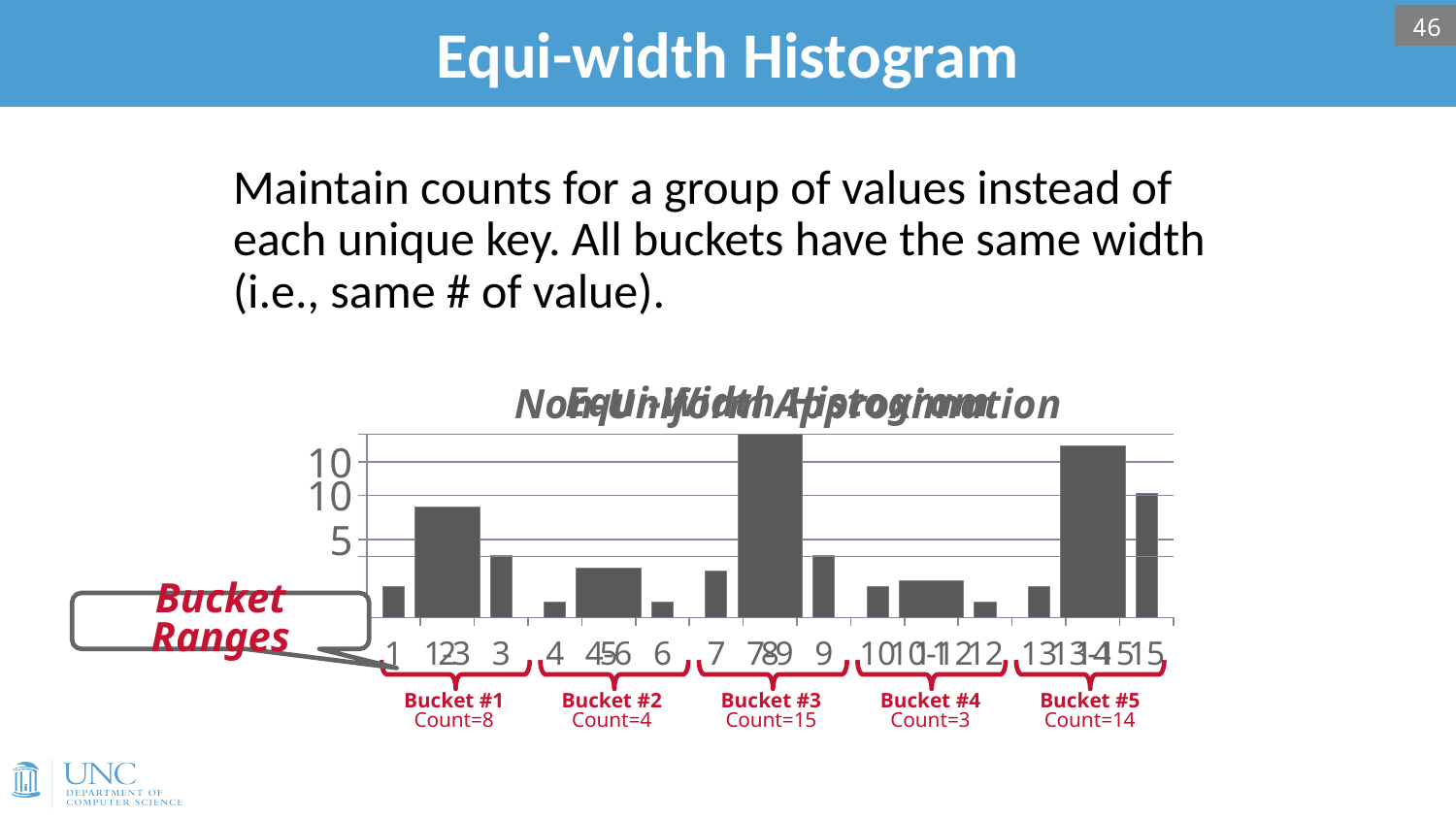
What kind of chart is shown on the slide? bar chart Which bucket has the highest count? Bucket #3 What is the count for Bucket #3? 15 Which has a larger count, Bucket #2 or Bucket #5? Bucket #5 What does the red label to the left of the x axis say? Bucket Ranges What is the count for Bucket #1? 8 What is the difference between the counts of Bucket #3 and Bucket #4? 12 What is the count for Bucket #5? 14 How many buckets are labeled below the chart? 5 Which bucket has the lowest count? Bucket #4